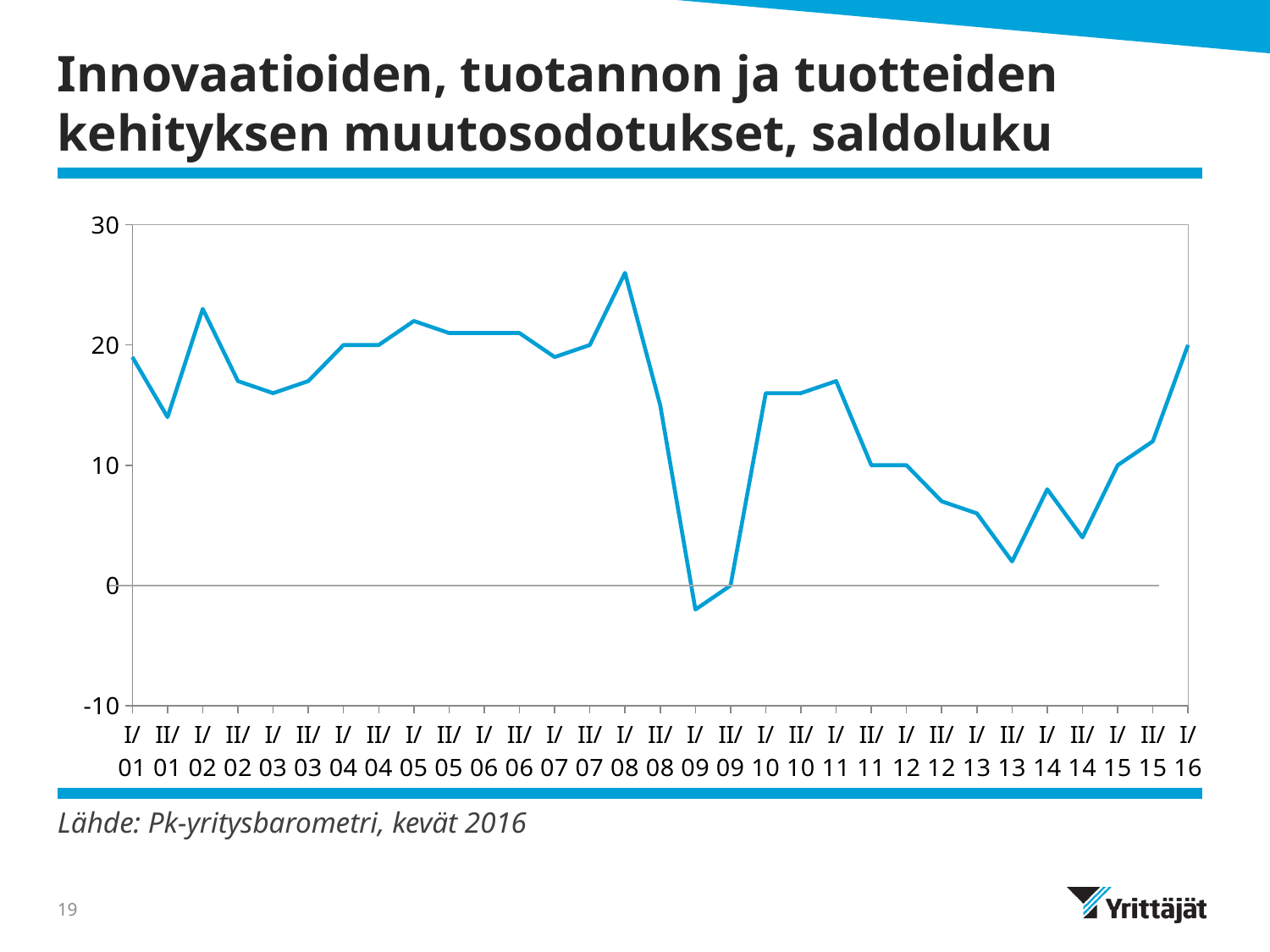
What kind of chart is shown on the slide? line chart Which is larger, the value for I/02 or the value for II/13? I/02 Is the value for I/08 greater or less than 20? greater How many periods are plotted on the x axis? 31 Is the value for I/09 greater or less than 0? less Is the value for II/13 greater or less than 10? less Which period has the highest value on the chart? I/08 Which period has the lowest value on the chart? I/09 What is the source given below the chart? Pk-yritysbarometri, kevät 2016 Do the values rise or fall from I/11 to II/13? fall